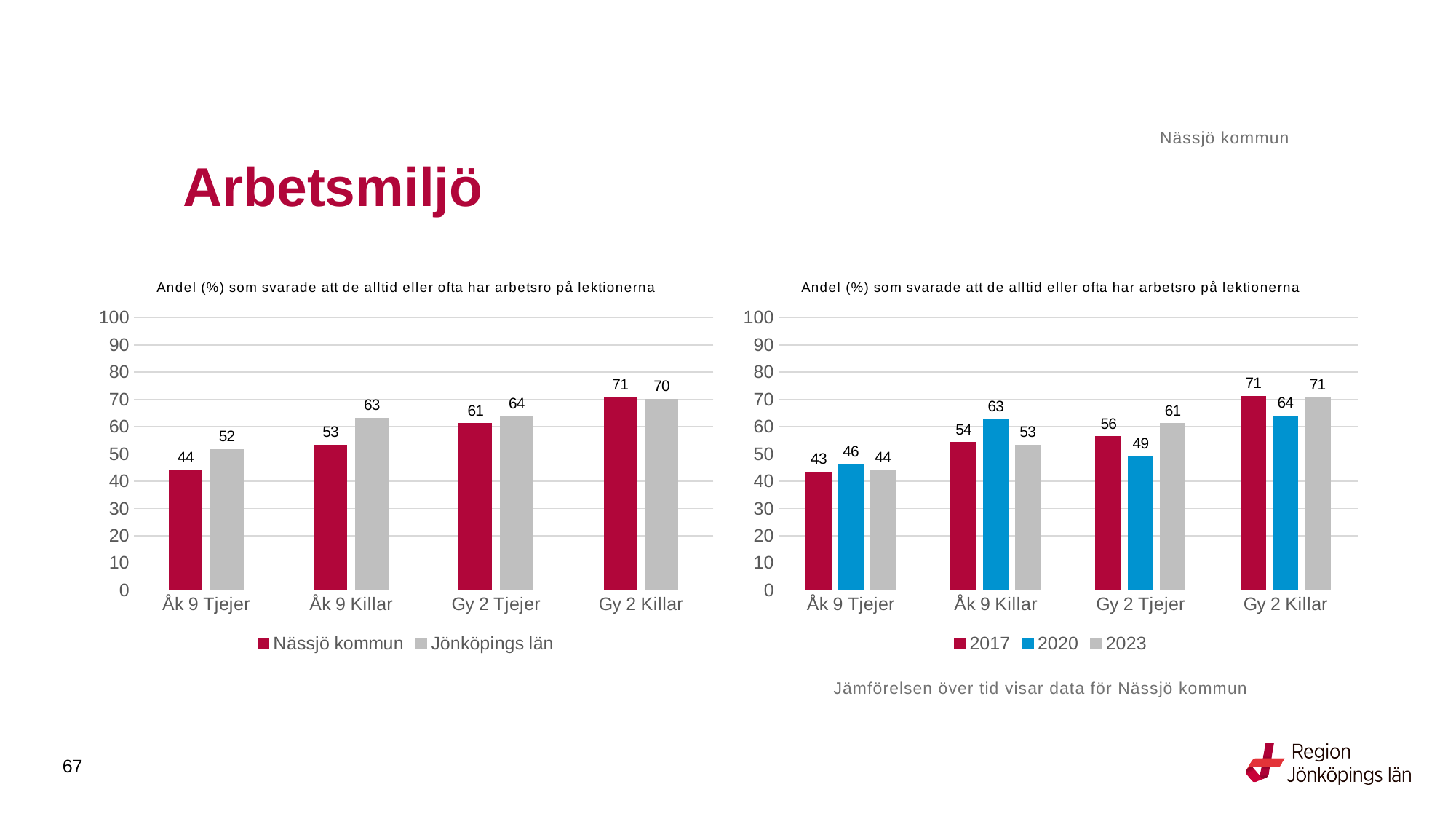
In the left chart, what is the value for Jönköpings län for Gy 2 Tjejer? 64 In the right chart, what is the value for 2023 for Åk 9 Killar? 53 In the left chart, how many series does the legend list? 2 In the right chart, which is larger for Åk 9 Killar: 2017 or 2020? 2020 In the left chart, what is the value for Nässjö kommun for Åk 9 Tjejer? 44 In the left chart, what is the difference between Jönköpings län and Nässjö kommun for Åk 9 Killar? 10 In the left chart, which category has the highest value for Nässjö kommun? Gy 2 Killar In the right chart, how many categories are shown on the x axis? 4 In the right chart, what is the value for 2020 for Gy 2 Tjejer? 49 In the right chart, what is the difference between 2023 and 2020 for Gy 2 Tjejer? 12 In the left chart, which category has the lowest value for Jönköpings län? Åk 9 Tjejer What type of chart is the right chart? Bar chart